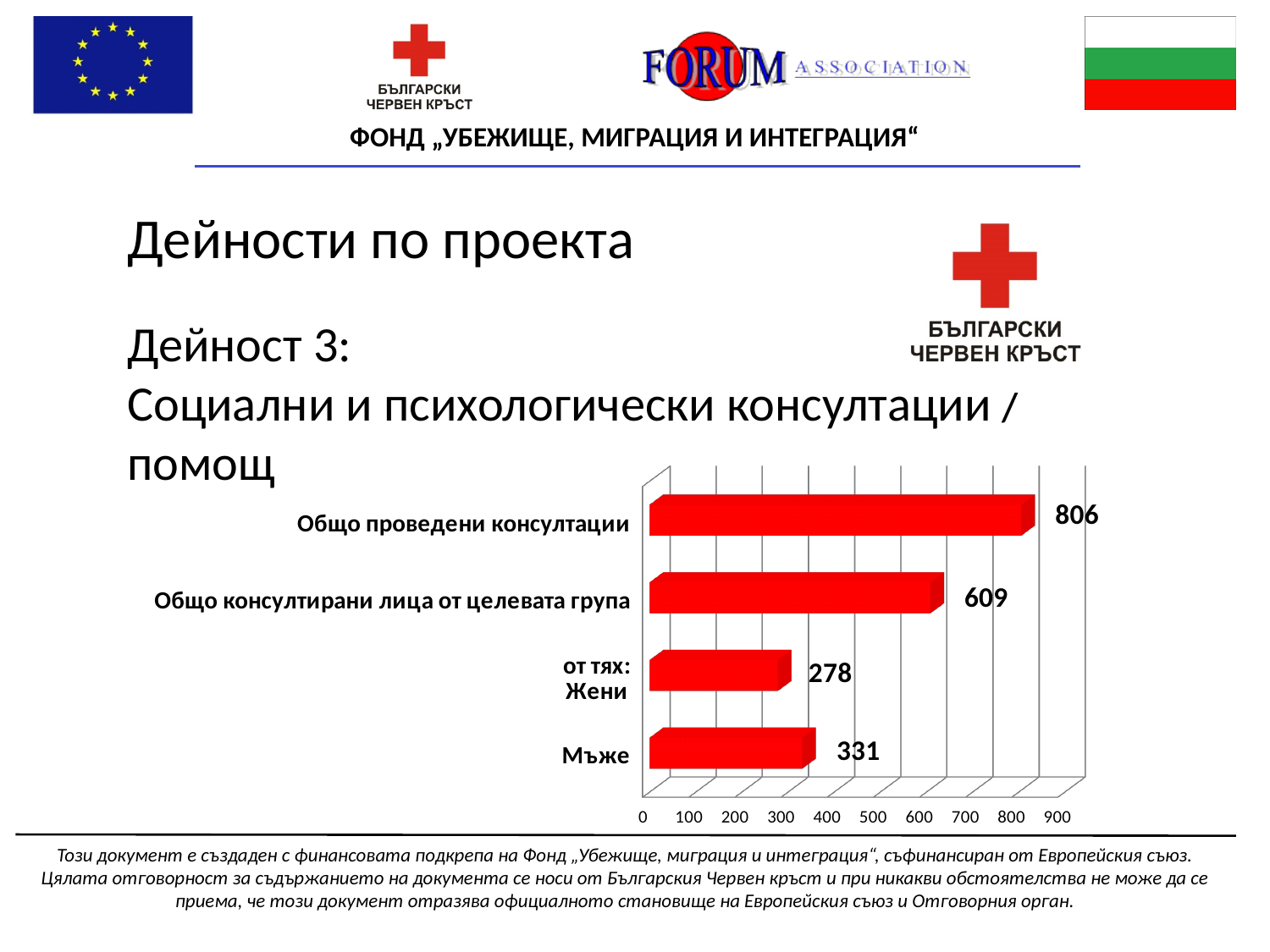
What is the difference between "Общо проведени консултации" and "Общо консултирани лица от целевата група"? 197 Is the value for "Общо консултирани лица от целевата група" greater or less than 500? greater Which category has the lowest value? Жени What is the value for "Общо консултирани лица от целевата група"? 609 What is the value for "Общо проведени консултации"? 806 What is the value for "Жени"? 278 Which is larger, the value for "Мъже" or the value for "Жени"? Мъже What kind of chart is shown on the slide? bar chart Which category has the highest value? Общо проведени консултации How many categories are shown in the chart? 4 What is the difference between the values for "Мъже" and "Жени"? 53 What is the value for "Мъже"? 331